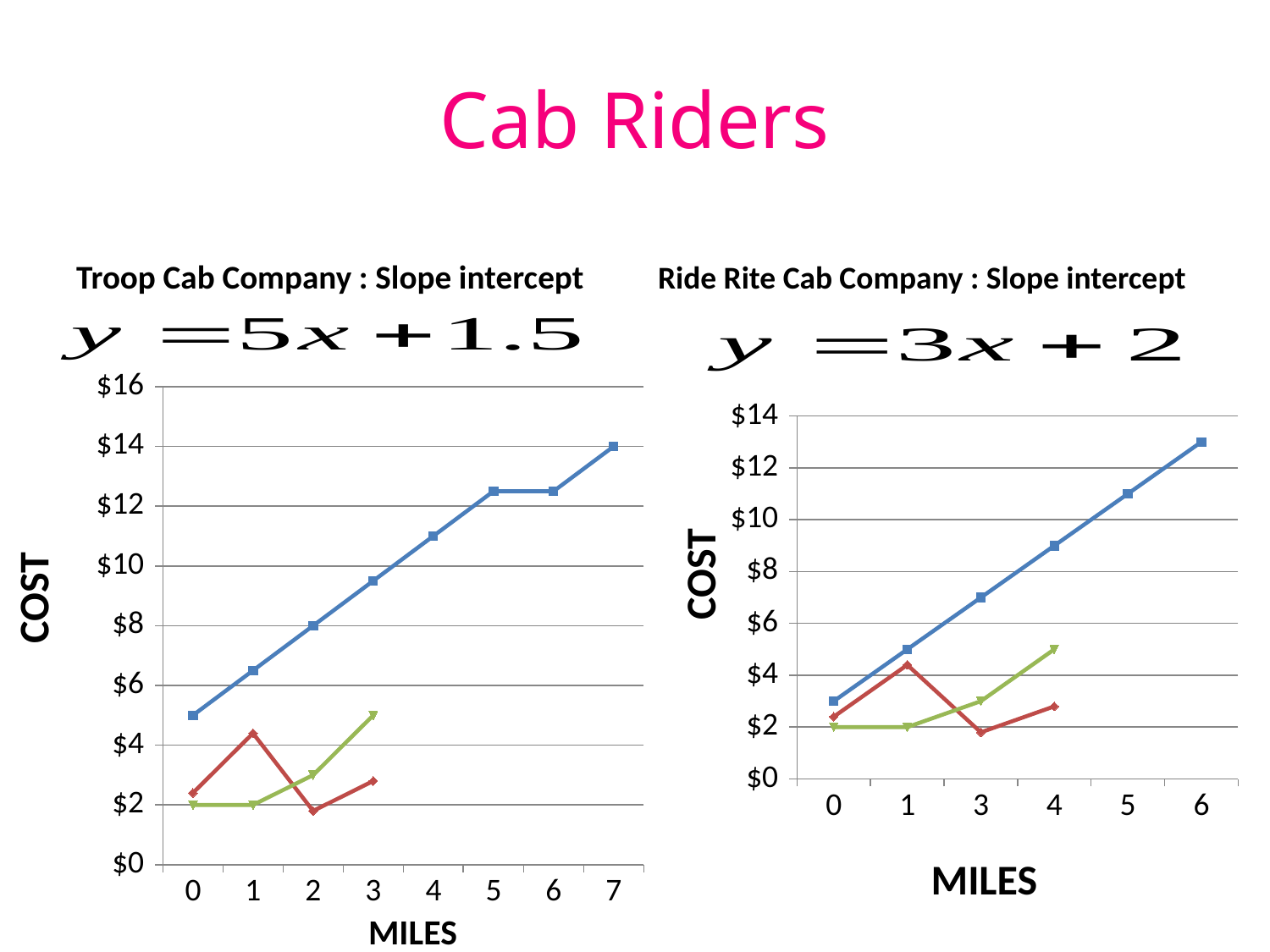
In the Ride Rite Cab Company chart, does the blue line rise or fall as miles increase? rise In the Ride Rite Cab Company chart, what is the cost shown by the green line at 1 mile? $2 In the Troop Cab Company chart, at how many miles does the blue line reach its highest cost? 7 How many mile values are labelled on the x axis of the Ride Rite Cab Company chart? 6 What type of chart is the Troop Cab Company chart? line chart In the Ride Rite Cab Company chart, is the blue line's value at 0 miles greater or less than $4? less In the Troop Cab Company chart, is the blue line's value at 5 miles greater or less than $12? greater In the Troop Cab Company chart, what is the cost shown by the blue line at 2 miles? $8 In the Troop Cab Company chart, what is the cost shown by the blue line at 7 miles? $14 In the Ride Rite Cab Company chart, is the blue line's value at 6 miles greater or less than $12? greater In the Troop Cab Company chart, what is the cost shown by the green line at 0 miles? $2 What equation is shown above the Troop Cab Company chart? y = 5x + 1.5